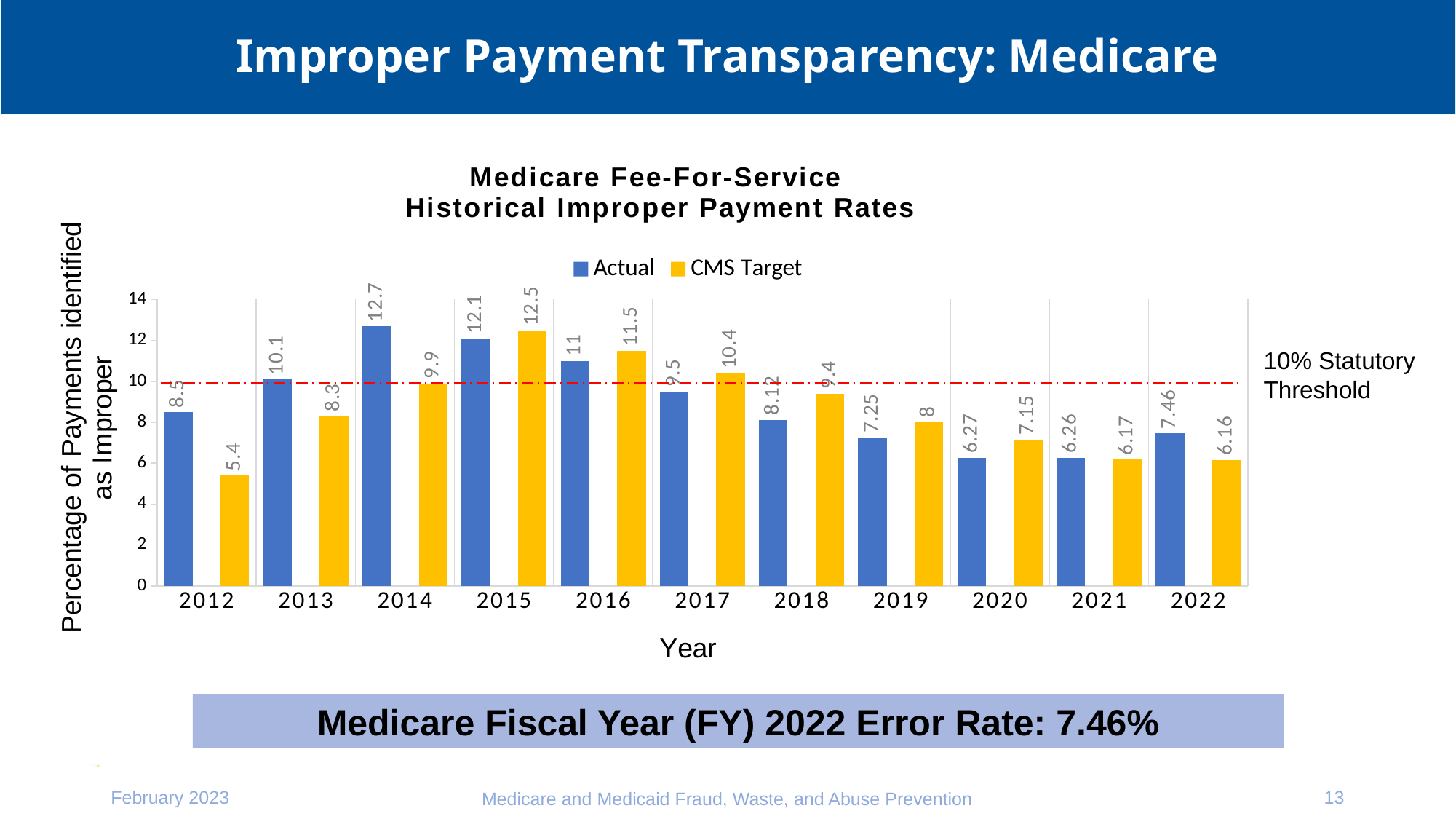
How many years are shown on the x axis of the chart? 11 What kind of chart is shown on the slide? Bar chart Which year has the highest Actual improper payment rate? 2014 What is the CMS Target value for 2022? 6.16 What does the red dashed horizontal line on the chart represent? 10% Statutory Threshold How many series does the legend list? 2 Do the Actual values rise or fall from 2014 to 2021? Fall Is the Actual value for 2020 greater or less than 8? less What is the Actual improper payment rate for 2014 in the Medicare Fee-For-Service Historical Improper Payment Rates chart? 12.7 In 2015, which is larger: the Actual rate or the CMS Target? CMS Target What is the difference between the Actual rate and the CMS Target for 2014? 2.8 Which year has the lowest CMS Target value? 2012